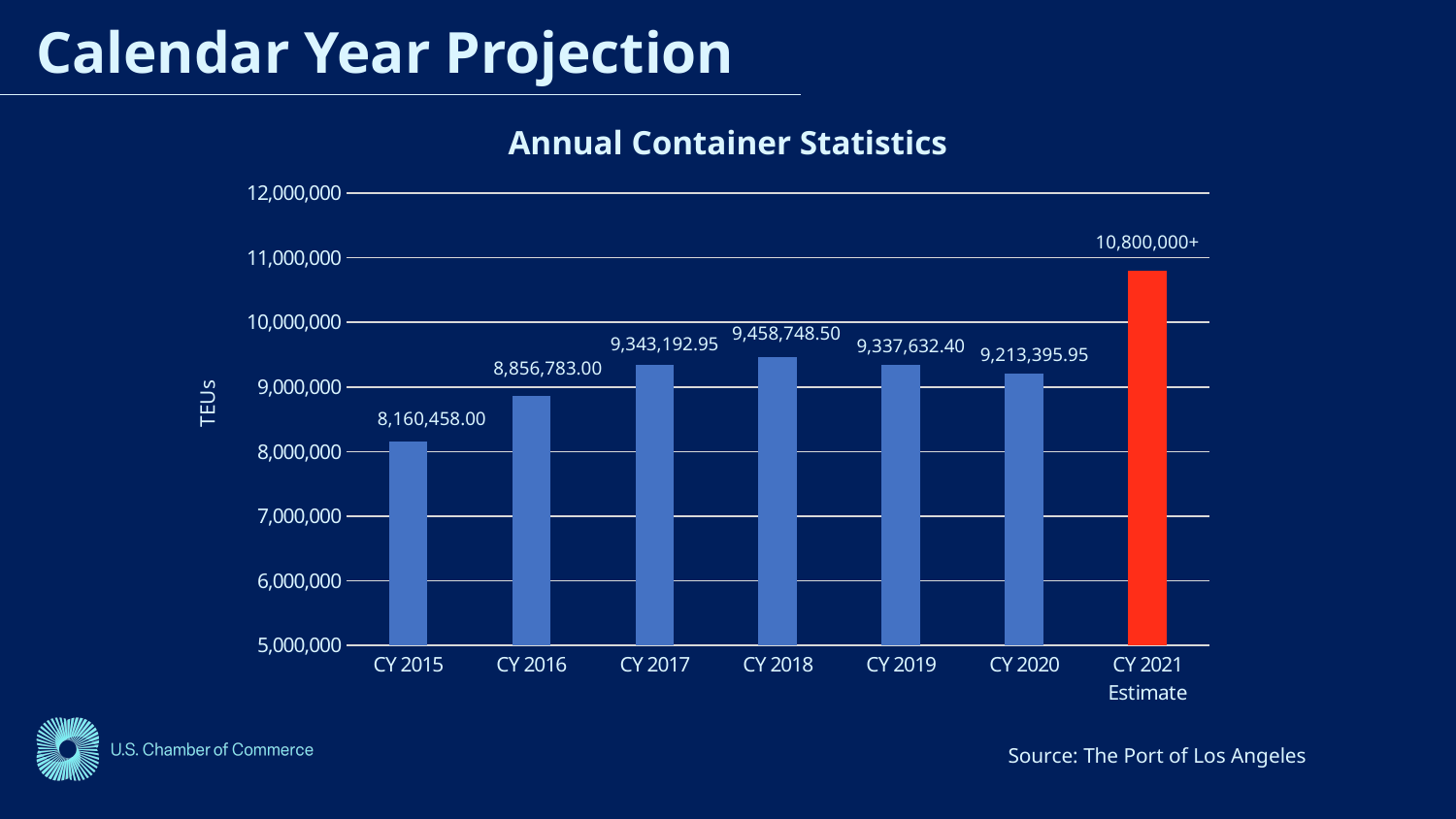
Which is larger, the value for CY 2016 or the value for CY 2020? CY 2020 What kind of chart is shown on the slide? bar chart Which category has the highest value? CY 2021 Estimate What is the value for CY 2018? 9,458,748.50 How many categories are shown on the x axis? 7 What is the value for CY 2015 in the Annual Container Statistics chart? 8,160,458.00 What is the difference between the CY 2016 and CY 2015 values? 696,325.00 What is the value shown for the CY 2021 Estimate? 10,800,000+ What is the value for CY 2020? 9,213,395.95 Is the value for CY 2015 greater or less than 9,000,000? less What is the difference between the CY 2018 and CY 2017 values? 115,555.55 Which category has the lowest value? CY 2015